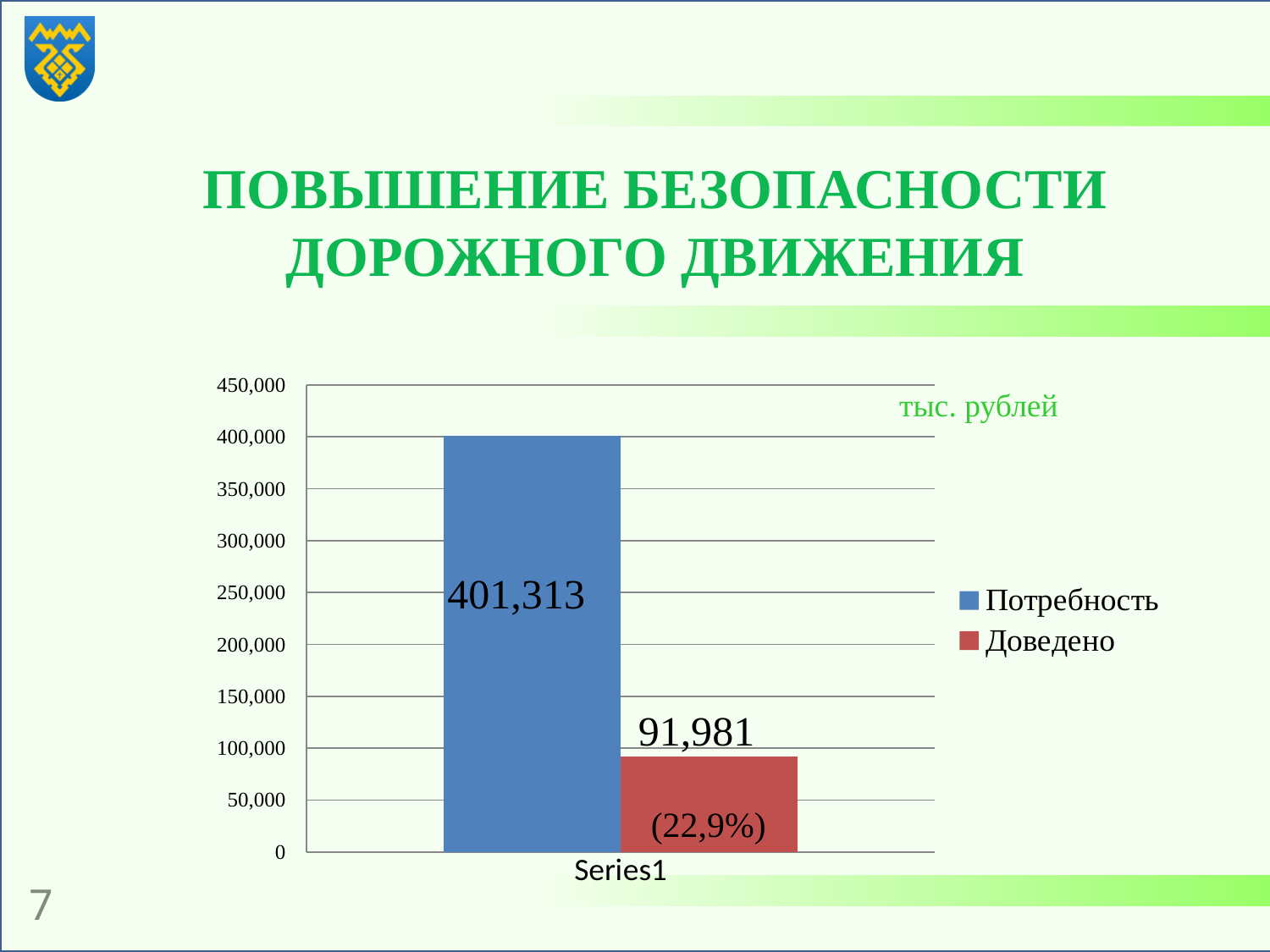
What is the difference between Потребность and Доведено? 309,332 Is the value for Доведено greater or less than 100,000? less What kind of chart is shown on the slide? bar chart What is the value for Потребность? 401,313 How many series does the legend list? 2 What percentage is printed on the Доведено bar? (22,9%) What is the value for Доведено? 91,981 What colour is the Потребность bar? blue Which series has the higher value, Потребность or Доведено? Потребность Is the value for Потребность greater or less than 400,000? greater Which series has the lowest value? Доведено What unit is indicated in the top right of the chart? тыс. рублей